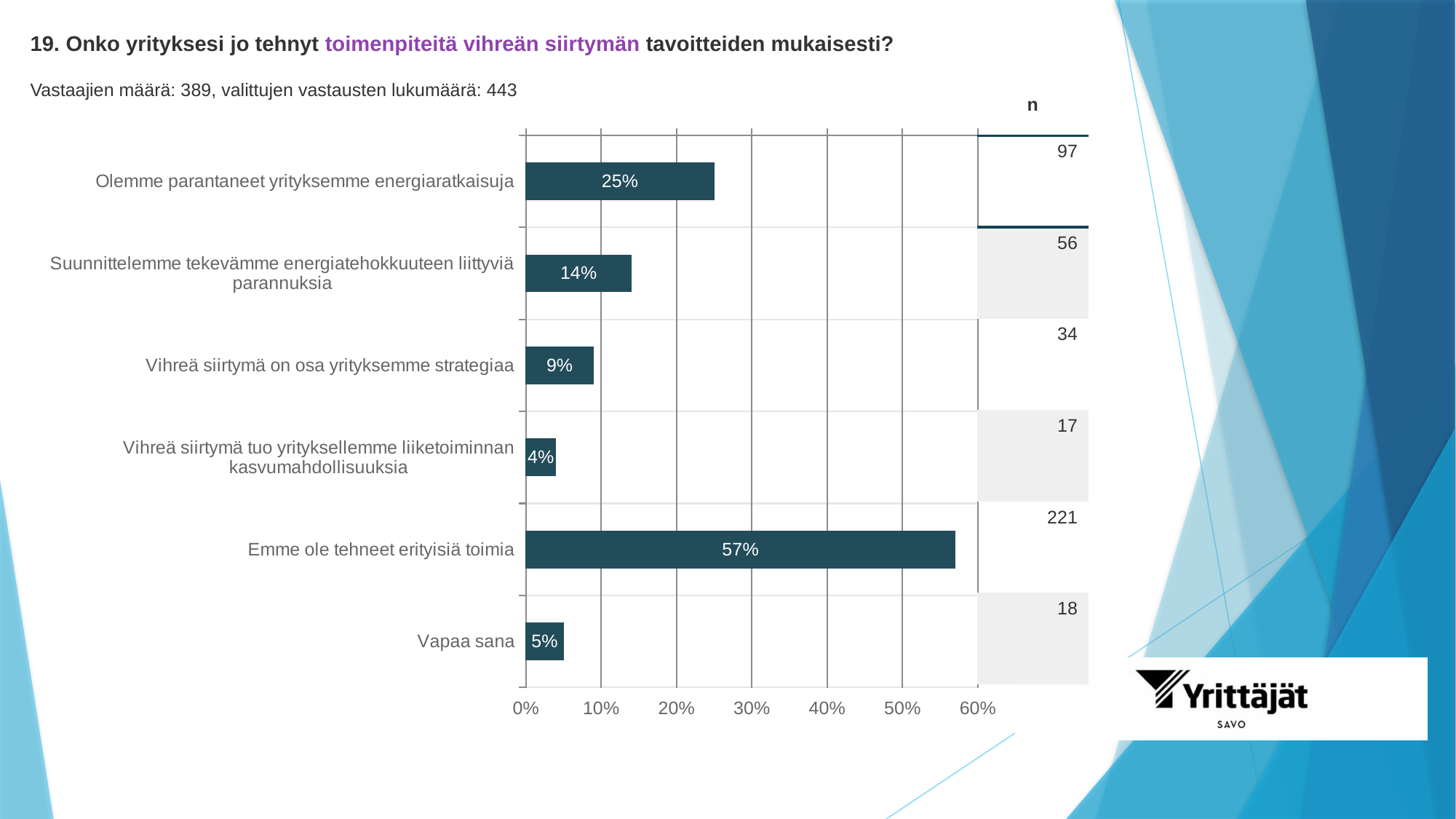
How many categories are shown in the chart? 6 What kind of chart is shown on the slide? Bar chart Which category has the highest percentage? Emme ole tehneet erityisiä toimia Which has a higher percentage: "Suunnittelemme tekevämme energiatehokkuuteen liittyviä parannuksia" or "Vihreä siirtymä on osa yrityksemme strategiaa"? Suunnittelemme tekevämme energiatehokkuuteen liittyviä parannuksia Is the value for "Emme ole tehneet erityisiä toimia" greater or less than 50%? greater What percentage is shown for "Emme ole tehneet erityisiä toimia"? 57% What is the n value for "Vapaa sana"? 18 What is the n value for "Vihreä siirtymä on osa yrityksemme strategiaa"? 34 What is the difference in percentage points between "Emme ole tehneet erityisiä toimia" and "Olemme parantaneet yrityksemme energiaratkaisuja"? 32 percentage points Which category has the lowest percentage? Vihreä siirtymä tuo yrityksellemme liiketoiminnan kasvumahdollisuuksia What percentage is shown for "Olemme parantaneet yrityksemme energiaratkaisuja"? 25% What is the number of respondents (Vastaajien määrä) stated on the slide? 389